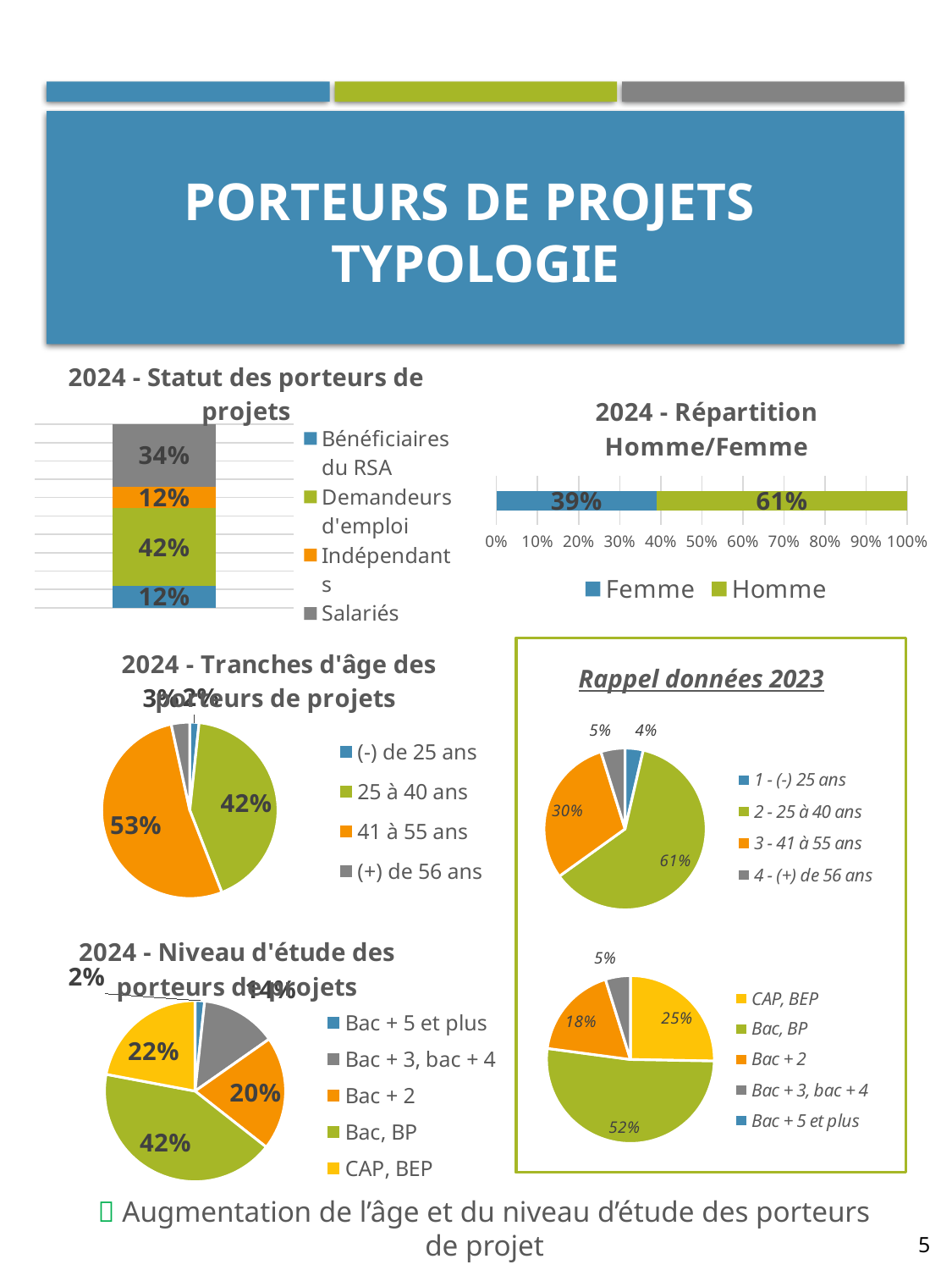
In the '2024 - Statut des porteurs de projets' chart, which status has the largest share? Demandeurs d'emploi In the '2024 - Statut des porteurs de projets' chart, what percentage is shown for Salariés? 34% What type of chart is '2024 - Répartition Homme/Femme'? Bar chart In the '2024 - Tranches d'âge des porteurs de projets' pie chart, which age group has the largest slice? 41 à 55 ans In the '2024 - Répartition Homme/Femme' chart, what is the difference between the Homme and Femme percentages? 22% In the '2024 - Niveau d'étude des porteurs de projets' pie chart, what percentage is shown for Bac, BP? 42% In the '2024 - Niveau d'étude des porteurs de projets' pie chart, which is larger: CAP, BEP or Bac + 2? CAP, BEP In the 2023 age pie chart inside 'Rappel données 2023', what percentage is shown for 2 - 25 à 40 ans? 61% How many entries does the legend of the '2024 - Statut des porteurs de projets' chart list? 4 In the 2023 education pie chart inside 'Rappel données 2023', what percentage is shown for Bac + 2? 18% In the '2024 - Tranches d'âge des porteurs de projets' pie chart, what percentage is shown for 41 à 55 ans? 53% In the '2024 - Répartition Homme/Femme' chart, what percentage is shown for Femme? 39%